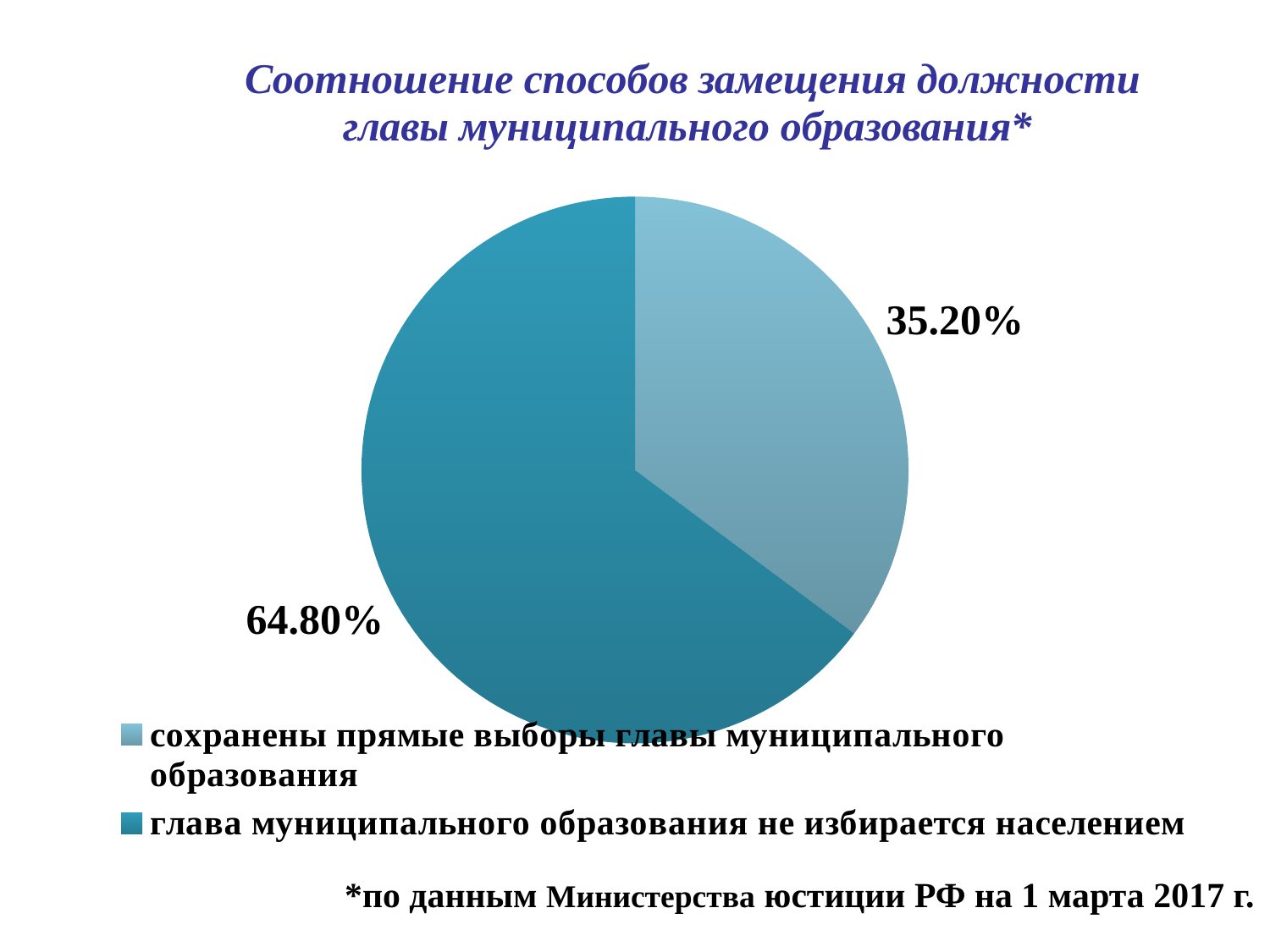
What is the value for the slice 'глава муниципального образования не избирается населением'? 64.80% What is the value for the slice 'сохранены прямые выборы главы муниципального образования'? 35.20% What kind of chart is shown on the slide? pie chart Which is larger: the slice for 'сохранены прямые выборы главы муниципального образования' or the slice for 'глава муниципального образования не избирается населением'? глава муниципального образования не избирается населением How many slices does the pie chart have? 2 How many entries does the legend list? 2 What is the difference between the two slices' values? 29.60% According to the footnote, what is the data source and date for the chart? по данным Министерства юстиции РФ на 1 марта 2017 г. Which category has the smallest slice of the pie? сохранены прямые выборы главы муниципального образования Which category has the largest slice of the pie? глава муниципального образования не избирается населением What share of the pie does the slice 'глава муниципального образования не избирается населением' represent? 64.80% What is the title of the chart? Соотношение способов замещения должности главы муниципального образования*